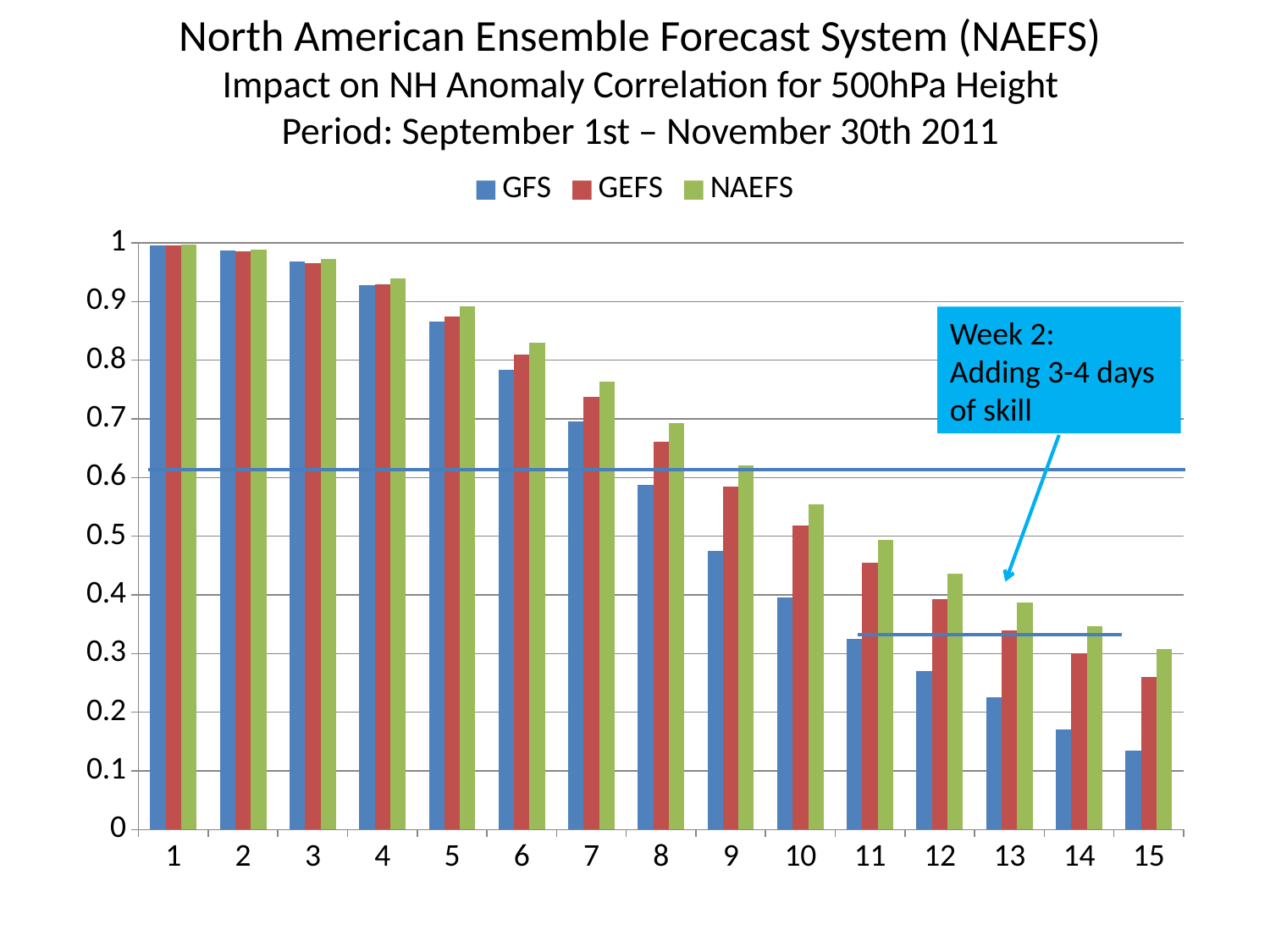
Is the NAEFS value at category 7 greater or less than 0.7? greater How many categories are shown along the x axis? 15 Is the GEFS value at category 10 greater or less than 0.5? greater What are the three series names listed in the legend? GFS, GEFS, NAEFS Is the GFS value at category 15 greater or less than 0.2? less Do the GFS values rise or fall as the category number increases from 1 to 15? fall At category 15, which is larger, the GFS value or the NAEFS value? NAEFS Which series has the highest value at category 10? NAEFS What kind of chart is shown on the slide? bar chart Which series has the lowest value at category 14? GFS How many series does the legend list? 3